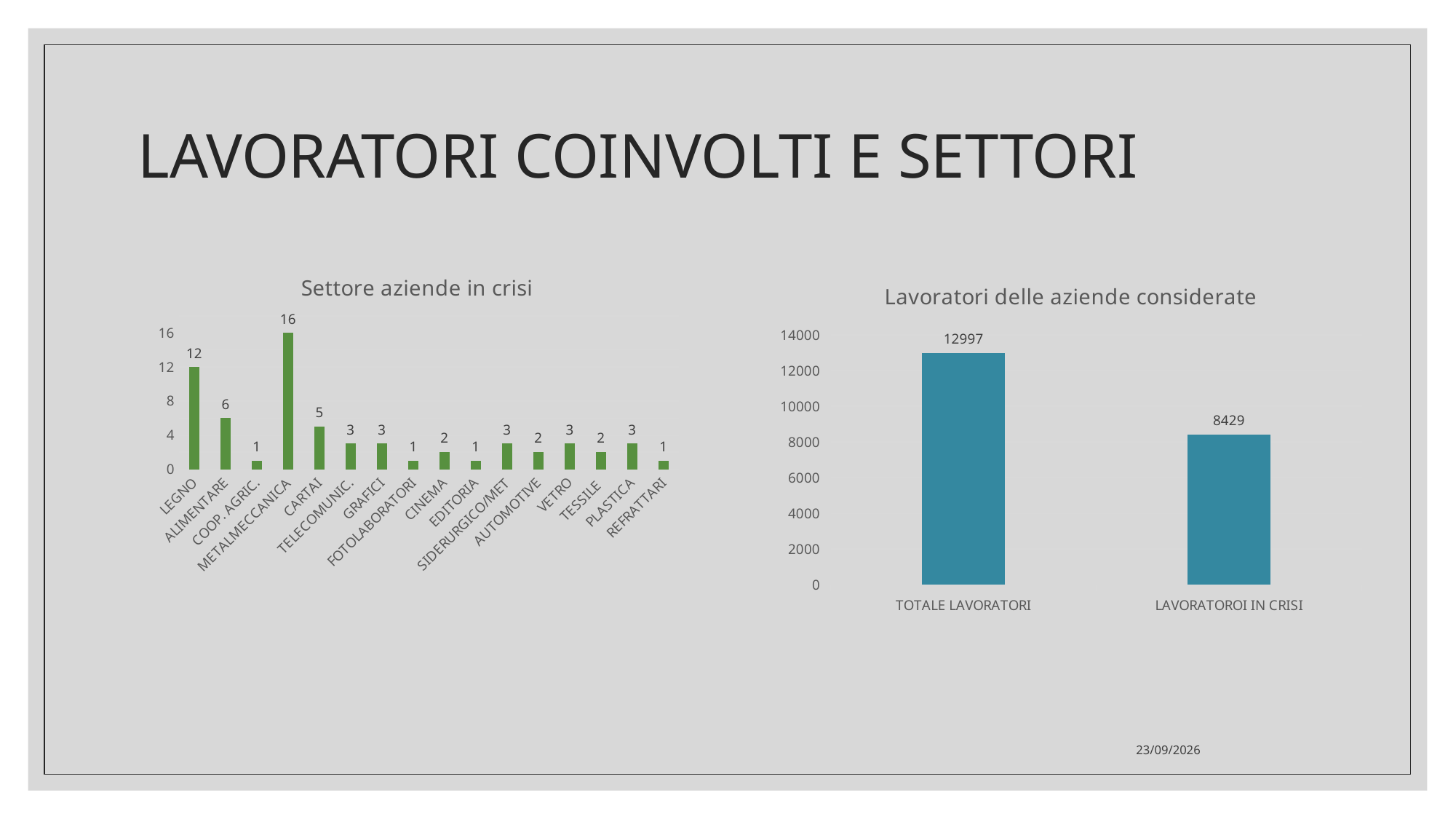
In the 'Settore aziende in crisi' chart, what is the difference between the values for METALMECCANICA and LEGNO? 4 How many sectors are shown in the 'Settore aziende in crisi' chart? 16 In the 'Settore aziende in crisi' chart, what is the value for METALMECCANICA? 16 In the 'Settore aziende in crisi' chart, which is larger, the value for ALIMENTARE or the value for CARTAI? ALIMENTARE What kind of chart is 'Settore aziende in crisi'? Bar chart How many bars are shown in the 'Lavoratori delle aziende considerate' chart? 2 In the 'Lavoratori delle aziende considerate' chart, what is the value for TOTALE LAVORATORI? 12997 In the 'Lavoratori delle aziende considerate' chart, what is the value for LAVORATOROI IN CRISI? 8429 In the 'Settore aziende in crisi' chart, what is the value for CARTAI? 5 In the 'Settore aziende in crisi' chart, which sector has the highest value? METALMECCANICA In the 'Settore aziende in crisi' chart, what is the value for LEGNO? 12 In the 'Lavoratori delle aziende considerate' chart, what is the difference between TOTALE LAVORATORI and LAVORATOROI IN CRISI? 4568